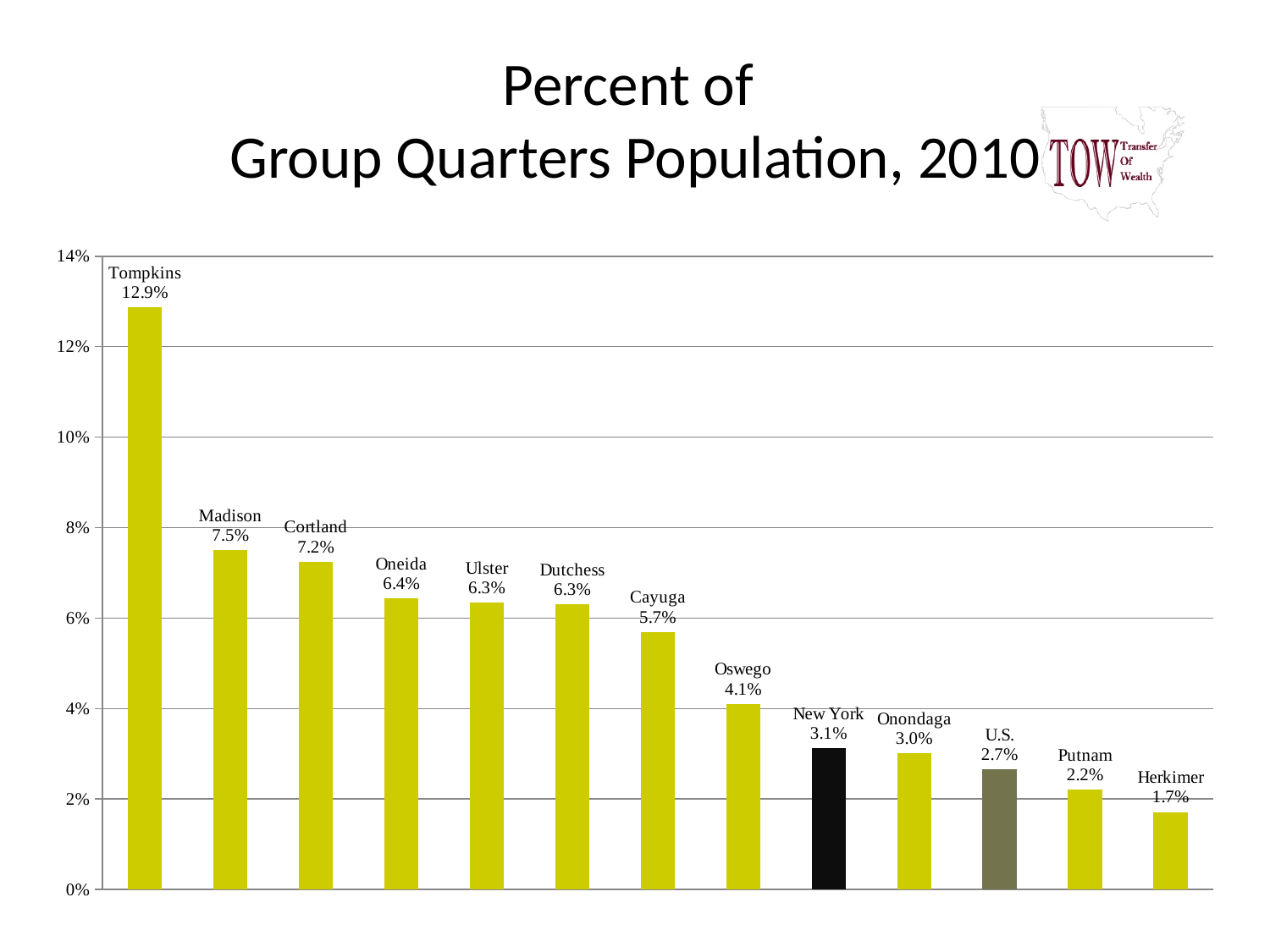
What is the value shown for Oswego? 4.1% Which is larger, the value for Oneida or the value for Cayuga? Oneida Which category has the lowest percent of group quarters population? Herkimer Which category has the highest percent of group quarters population? Tompkins What is the difference between the values for Tompkins and Herkimer? 11.2% What is the percent of group quarters population for Tompkins? 12.9% How many bars are plotted on the chart? 13 What kind of chart is shown on the slide? bar chart What is the value shown for the U.S.? 2.7% Is the value for New York greater or less than 4%? less Do the values rise or fall from left to right along the x axis? fall What is the difference between the values for Madison and Cortland? 0.3%